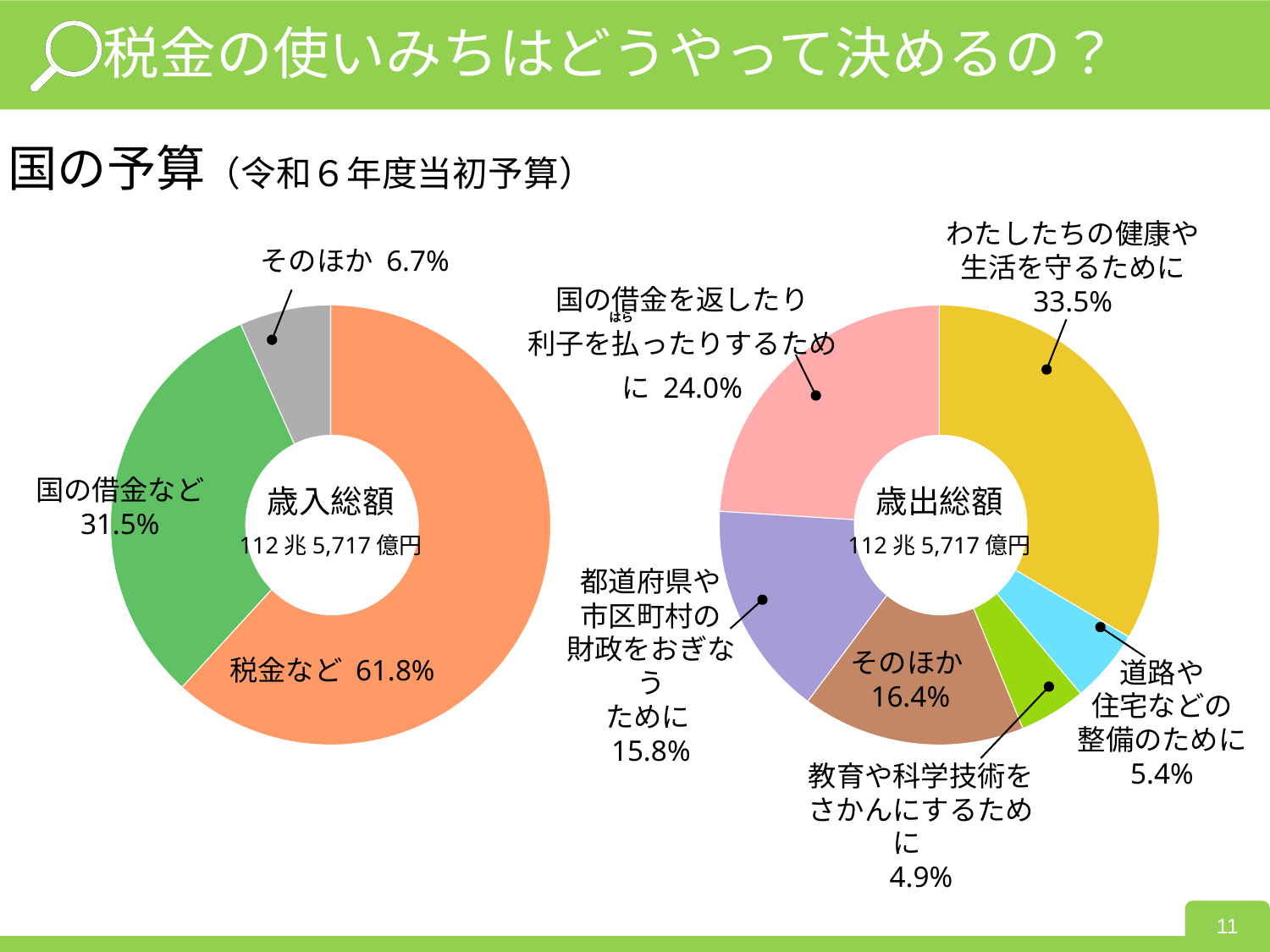
In the 歳入総額 chart on the left, what share is 国の借金など? 31.5% In the 歳入総額 chart on the left, what share is 税金など? 61.8% In the 歳入総額 chart on the left, which category has the smallest share? そのほか In the 歳出総額 chart on the right, how many categories are shown? 6 In the 歳出総額 chart on the right, what share is わたしたちの健康や生活を守るために? 33.5% In the 歳出総額 chart on the right, which category has the largest share? わたしたちの健康や生活を守るために What total amount is shown in the centre of the 歳出総額 chart on the right? 112兆5,717億円 In the 歳入総額 chart on the left, what is the difference between 税金など and 国の借金など? 30.3% In the 歳出総額 chart on the right, which is larger: 国の借金を返したり利子を払ったりするために or 都道府県や市区町村の財政をおぎなうために? 国の借金を返したり利子を払ったりするために In the 歳出総額 chart on the right, which category has the smallest share? 教育や科学技術をさかんにするために In the 歳出総額 chart on the right, what share is 道路や住宅などの整備のために? 5.4% In the 歳入総額 chart on the left, how many categories are shown? 3